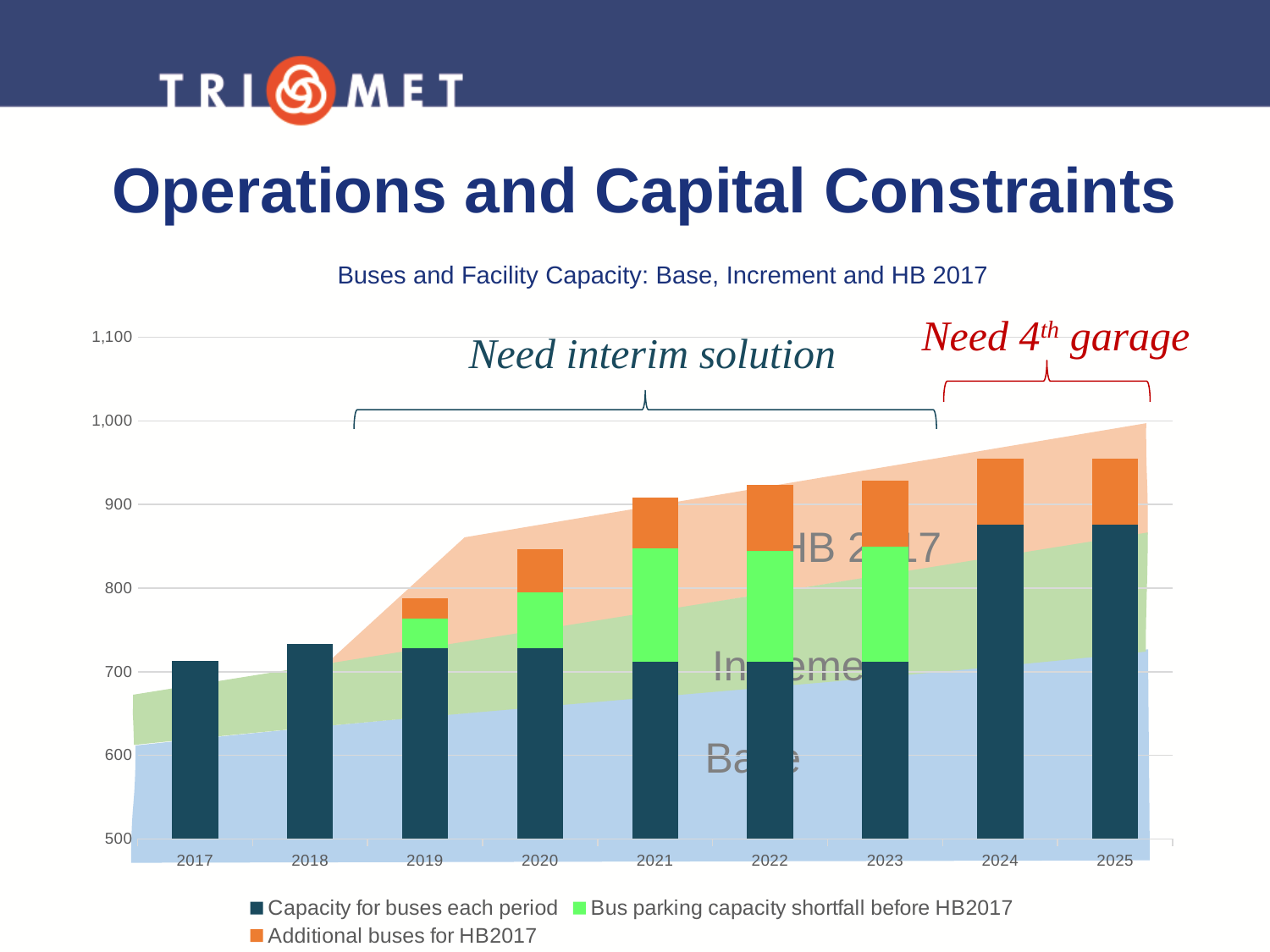
Is the total height of the stacked bar for 2025 greater or less than 900? greater What is the title of the chart? Buses and Facility Capacity: Base, Increment and HB 2017 What kind of chart is shown on the slide? Bar chart How many series does the chart's legend list? 3 Is the total height of the stacked bar for 2019 greater or less than 800? less Which year has the larger total stacked bar, 2019 or 2020? 2020 How many years are shown on the x axis of the chart? 9 Is the value for 'Capacity for buses each period' in 2017 greater or less than 700? greater Do the total stacked bar heights generally rise or fall from 2017 to 2025? Rise Which colour represents 'Additional buses for HB2017' in the legend? Orange Which year has the lowest total stacked bar? 2017